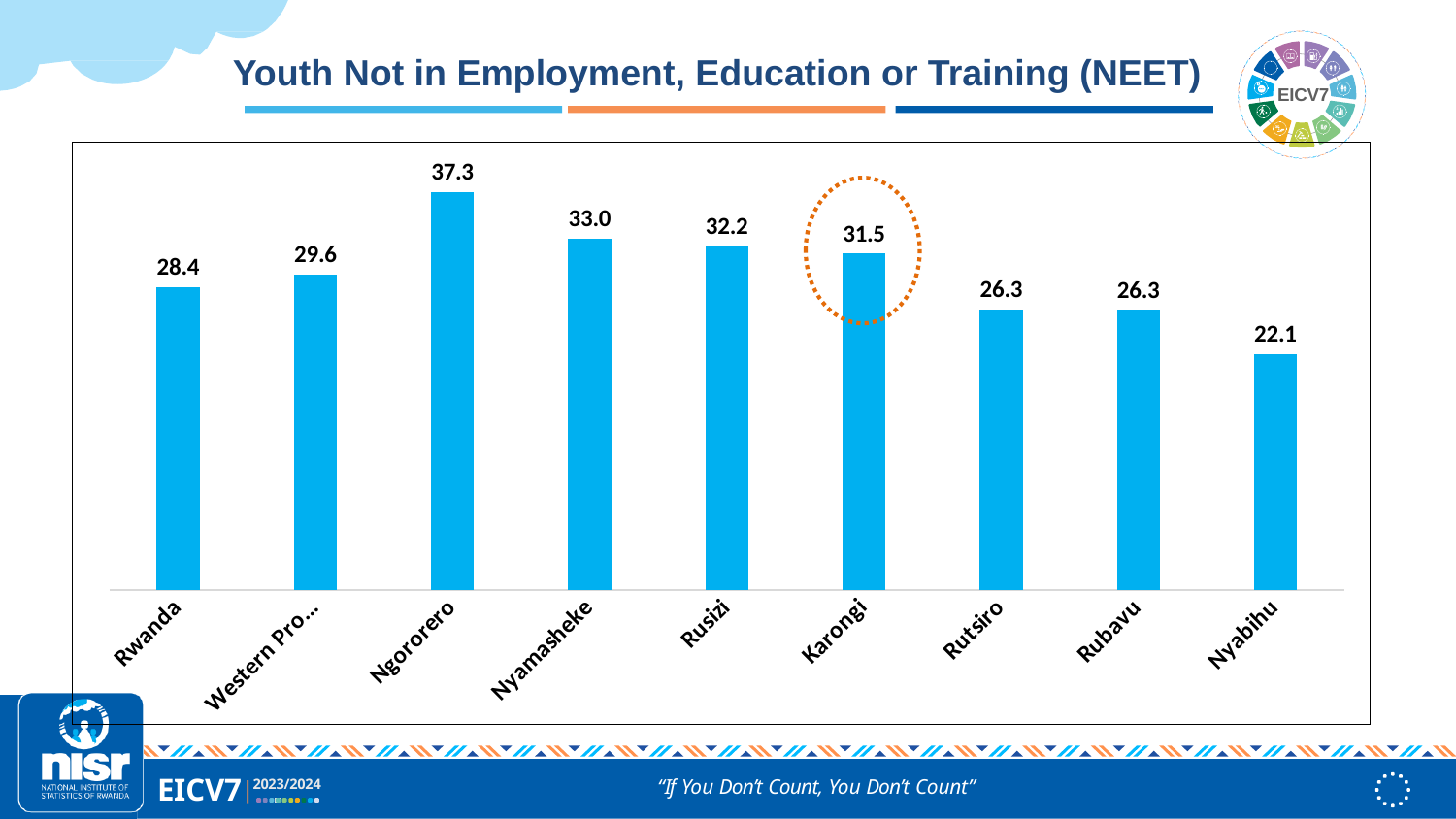
What is the NEET value for Nyabihu? 22.1 What is the NEET value for Karongi? 31.5 What is the difference between the NEET values for Rusizi and Rwanda? 3.8 How many categories are shown on the chart? 9 What is the difference between the NEET values for Ngororero and Nyabihu? 15.2 What is the NEET value for Rwanda? 28.4 What is the NEET value for Ngororero? 37.3 Which category has the lowest NEET value? Nyabihu Which has a higher NEET value, Nyamasheke or Rusizi? Nyamasheke Which district's bar is highlighted with a dotted orange circle? Karongi What kind of chart is shown on the slide? Bar chart Which district has the highest NEET value? Ngororero